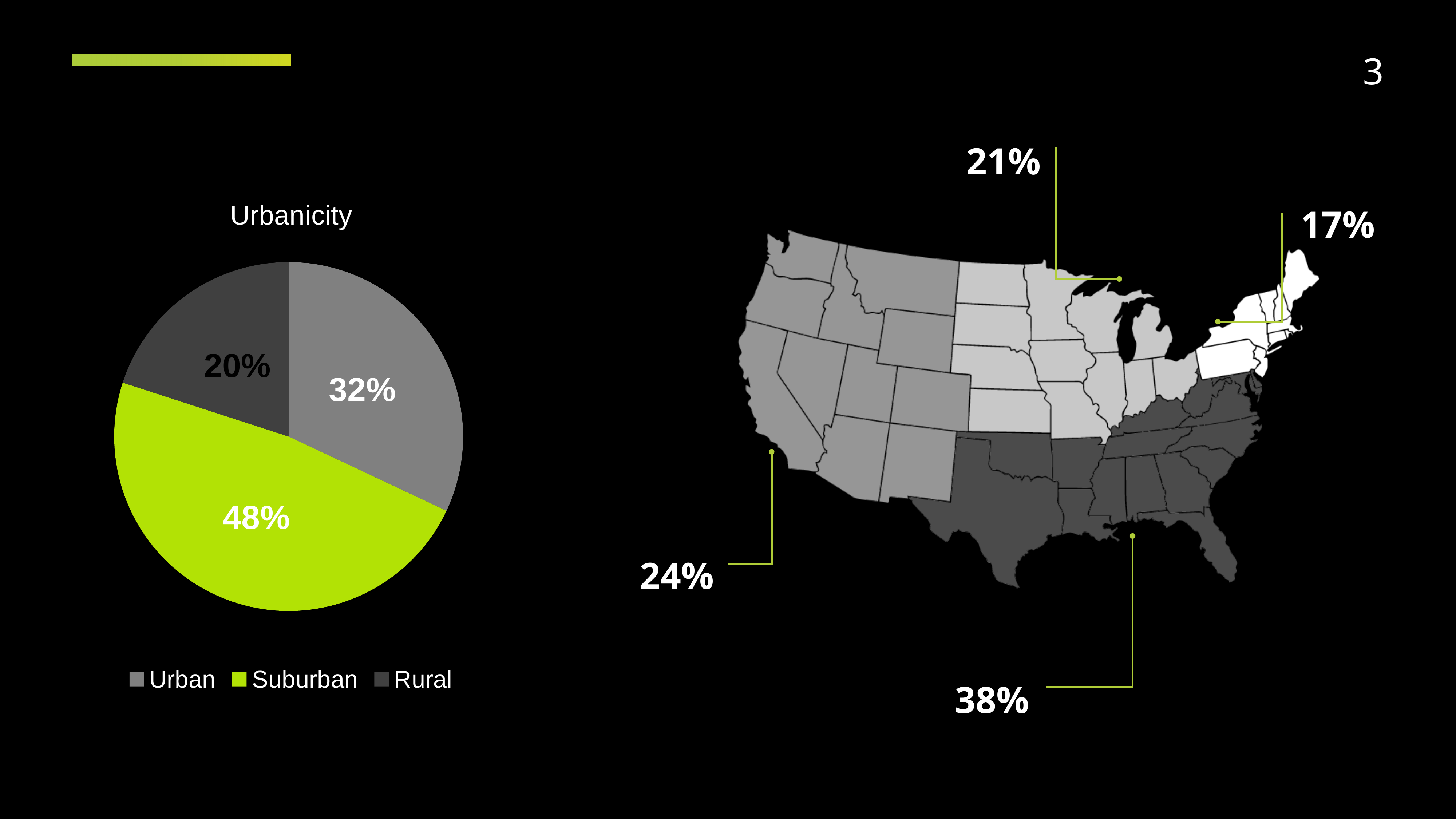
In the Urbanicity pie chart, what share is Urban? 32% In the Urbanicity pie chart, which is larger, Urban or Rural? Urban In the Urbanicity pie chart, which category has the largest slice? Suburban How many categories does the legend of the Urbanicity pie chart list? 3 In the Urbanicity pie chart, what share is Rural? 20% In the Urbanicity pie chart, which category has the smallest slice? Rural On the US map on the right of the slide, what is the highest percentage shown? 38% In the Urbanicity pie chart, which category is shown in green? Suburban In the Urbanicity pie chart, what is the difference in percentage points between Suburban and Urban? 16 What is the title of the pie chart on the left of the slide? Urbanicity In the Urbanicity pie chart, what share is Suburban? 48% What kind of chart is the Urbanicity chart? pie chart